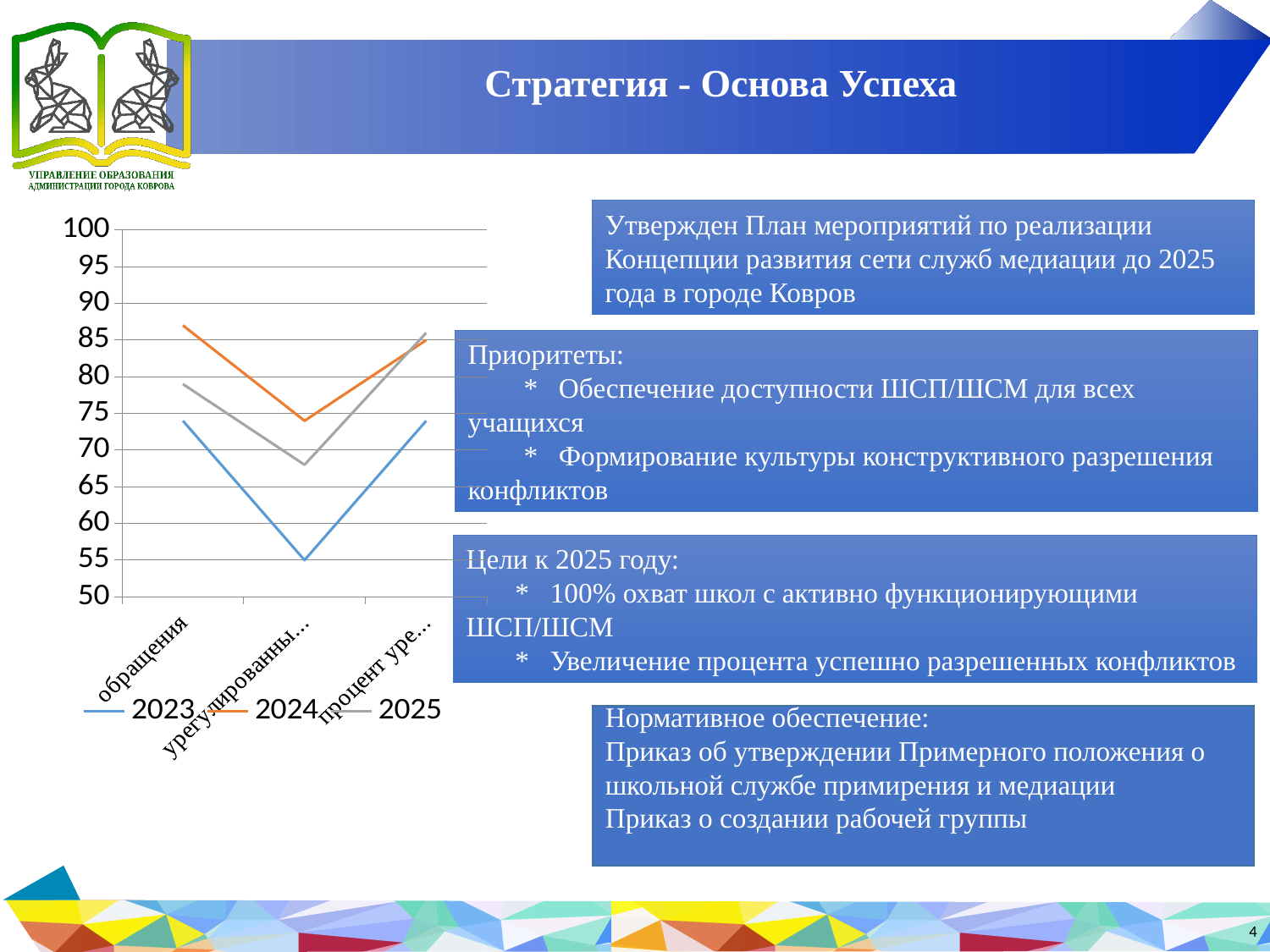
Which series has the lowest value for the category "обращения"? 2023 Is the 2024 value for "обращения" greater or less than 80? greater How many series does the chart legend list? 3 How many categories are plotted along the x axis of the chart? 3 What colour is the line for the 2024 series? orange Is the 2023 value for "обращения" greater or less than 70? greater What kind of chart is shown on the slide? line chart Which series has the highest value for the category "обращения"? 2024 Is the 2025 value for "обращения" greater or less than 75? greater For the category "обращения", which is larger: the 2023 value or the 2024 value? 2024 Does the 2023 line rise or fall from the first category to the second category? fall What is the highest value shown on the chart's vertical axis? 100